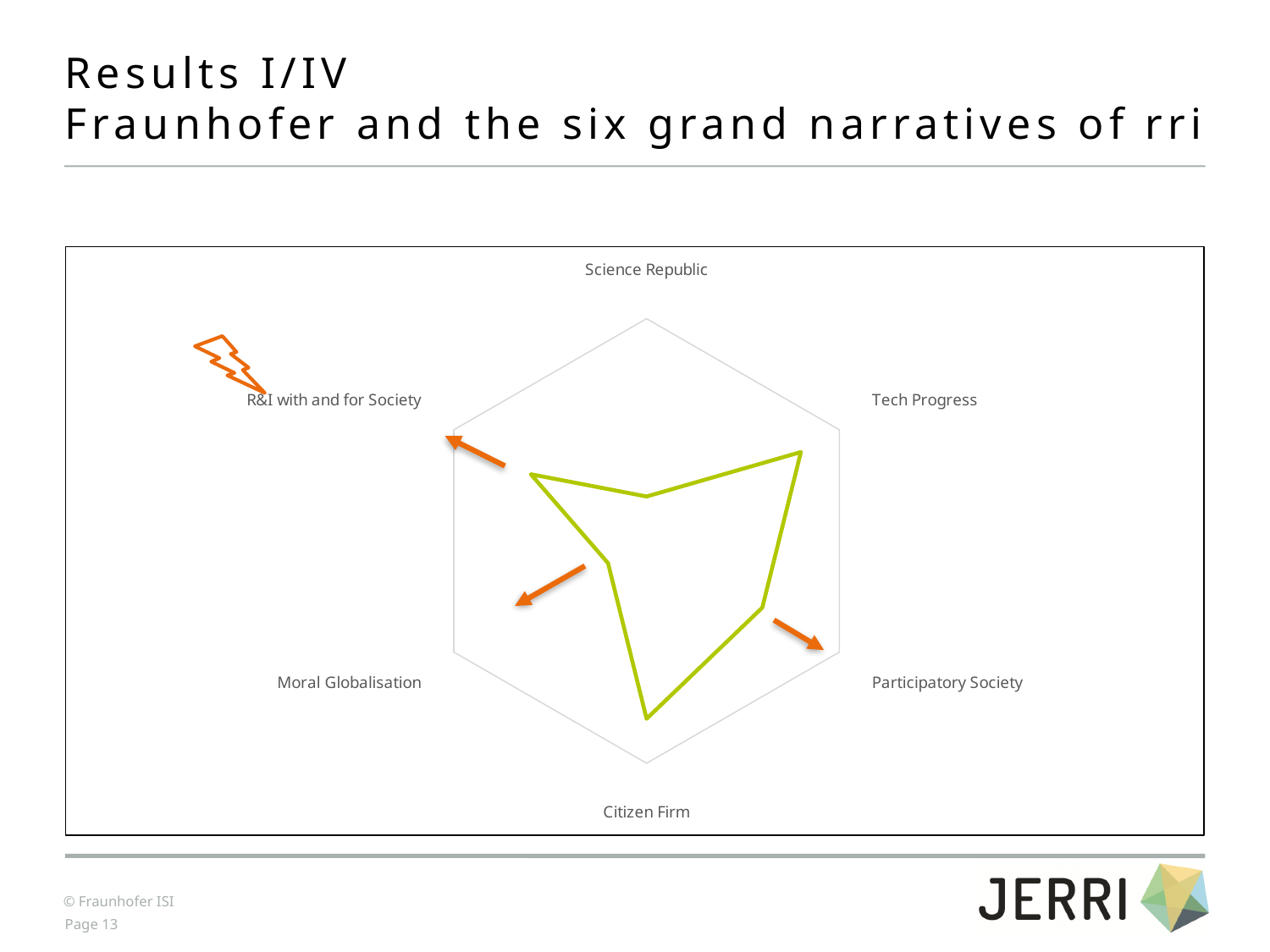
Which is larger on the radar chart, the value for R&I with and for Society or the value for Science Republic? R&I with and for Society Which category is plotted at the top of the radar chart? Science Republic Which is larger on the radar chart, the value for Citizen Firm or the value for Moral Globalisation? Citizen Firm Which is larger on the radar chart, the value for Tech Progress or the value for Science Republic? Tech Progress What kind of chart is shown on the slide? Radar chart How many categories (axes) does the radar chart have? 6 Which category on the radar chart is marked with an orange lightning-bolt icon? R&I with and for Society